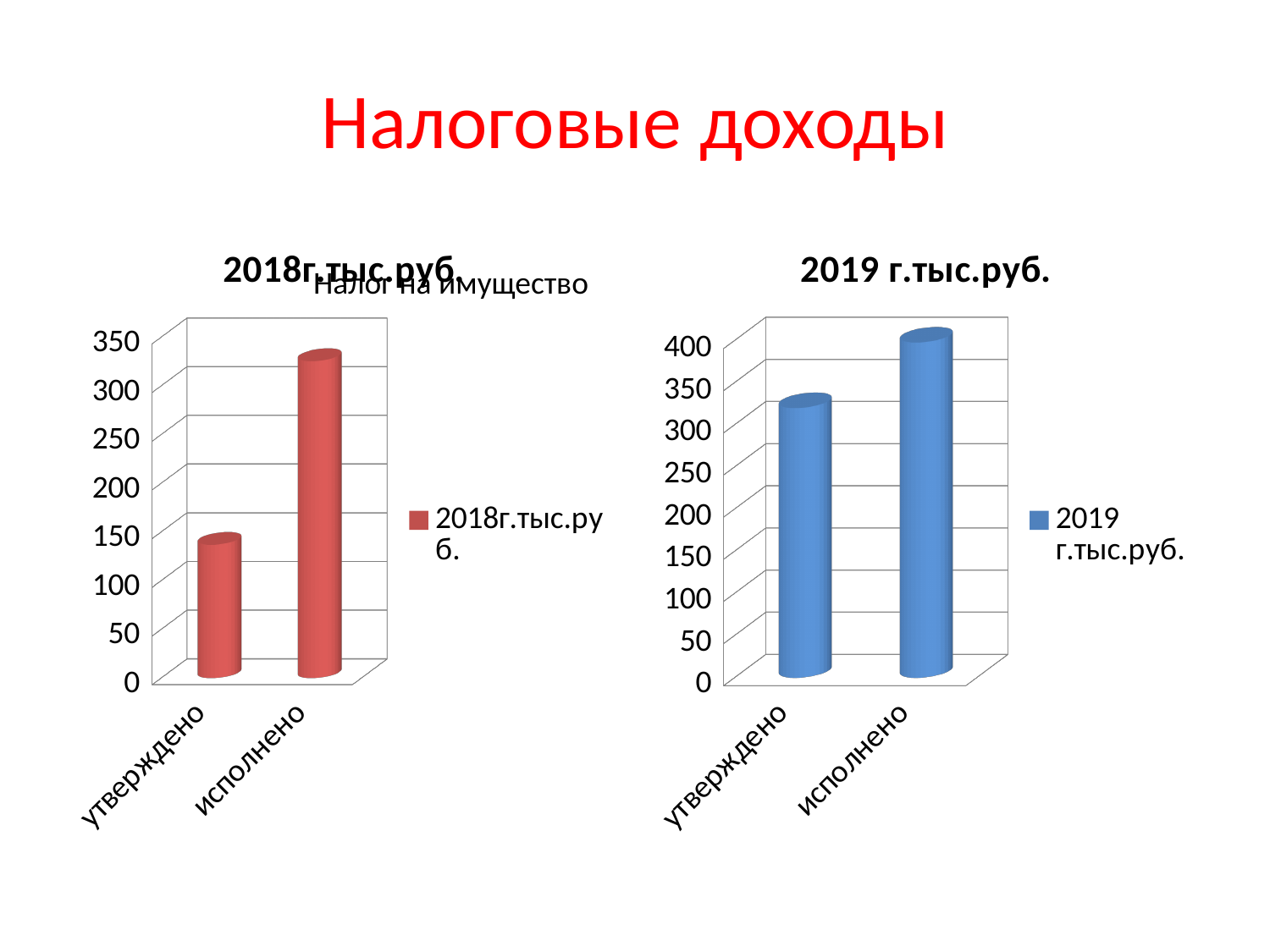
How many categories are shown on the x axis of the right chart (2019 г.тыс.руб.)? 2 In the right chart (2019 г.тыс.руб.), which category has the highest value? исполнено In the left chart (2018г.тыс.руб.), is the value for утверждено greater or less than 200? less In the left chart (2018г.тыс.руб.), which category has the higher value, утверждено or исполнено? исполнено What kind of chart is the left chart titled "2018г.тыс.руб."? bar chart What is the legend entry of the right chart (2019 г.тыс.руб.)? 2019 г.тыс.руб. In the left chart (2018г.тыс.руб.), is the value for исполнено greater or less than 300? greater In the right chart (2019 г.тыс.руб.), is the value for утверждено greater or less than 250? greater In the right chart (2019 г.тыс.руб.), which category has the lowest value? утверждено What colour are the bars in the right chart (2019 г.тыс.руб.)? blue How many series does the legend of the left chart (2018г.тыс.руб.) list? 1